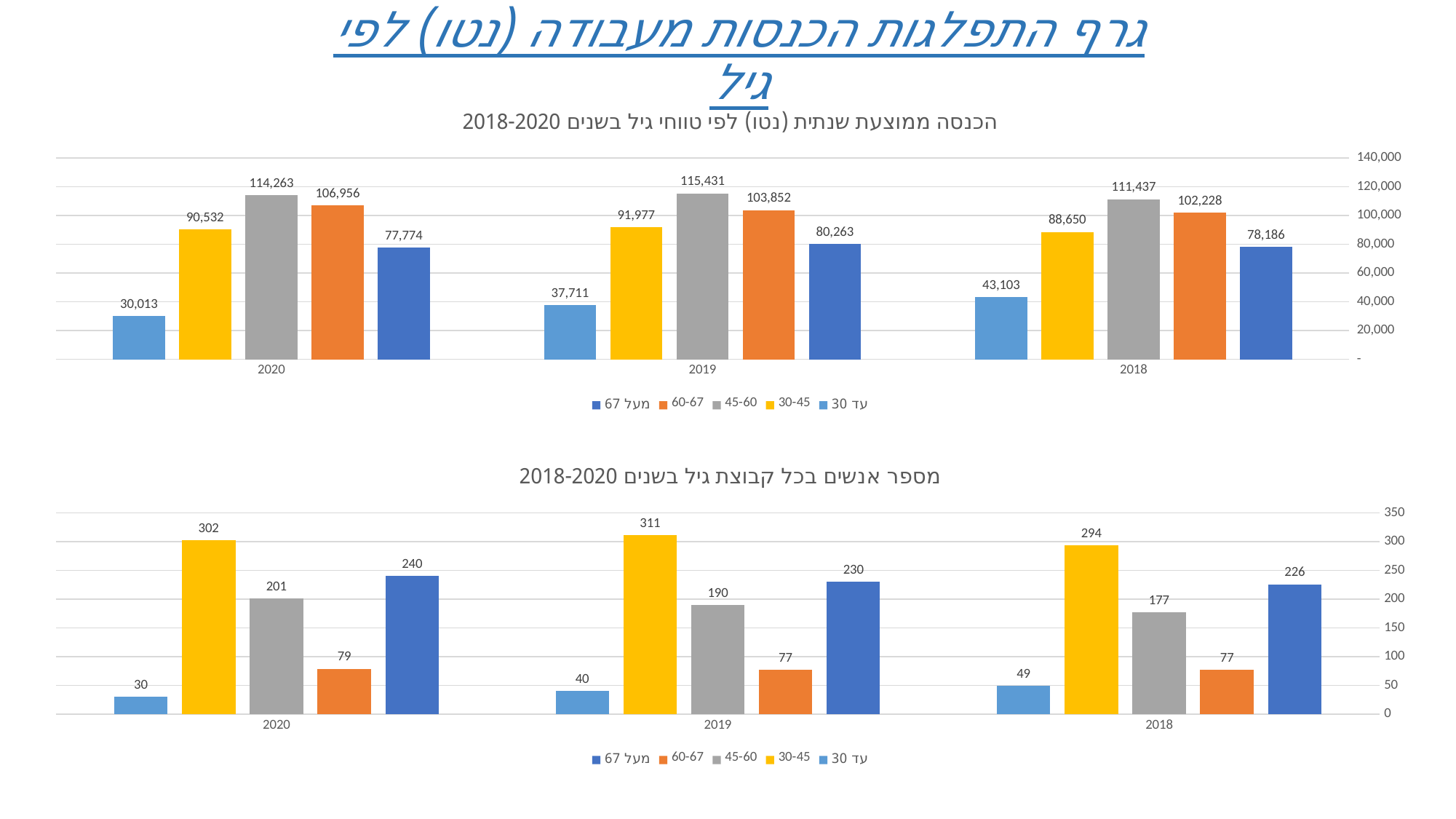
In the bottom chart (number of people in each age group), what is the value for the 30-45 age group in 2019? 311 In the top chart (average annual net income by age range), is the value for the מעל 67 group in 2018 greater or less than 80,000? less How many series does the legend of the bottom chart list? 5 In the top chart (average annual net income by age range), which age group has the highest value in 2020? 45-60 In the top chart (average annual net income by age range), which age group has the lowest value in 2019? עד 30 In the top chart (average annual net income by age range), what is the difference between the 45-60 and 60-67 values in 2020? 7,307 In the top chart (average annual net income by age range), what is the value for the עד 30 age group in 2018? 43,103 In the bottom chart (number of people in each age group), which is larger in 2018: the 45-60 group or the מעל 67 group? מעל 67 In the top chart (average annual net income by age range), what is the value for the 45-60 age group in 2019? 115,431 In the bottom chart (number of people in each age group), which age group has the lowest value in 2020? עד 30 In the bottom chart (number of people in each age group), what is the difference between the 30-45 and 45-60 values in 2018? 117 What type of chart is the top chart on the slide? bar chart